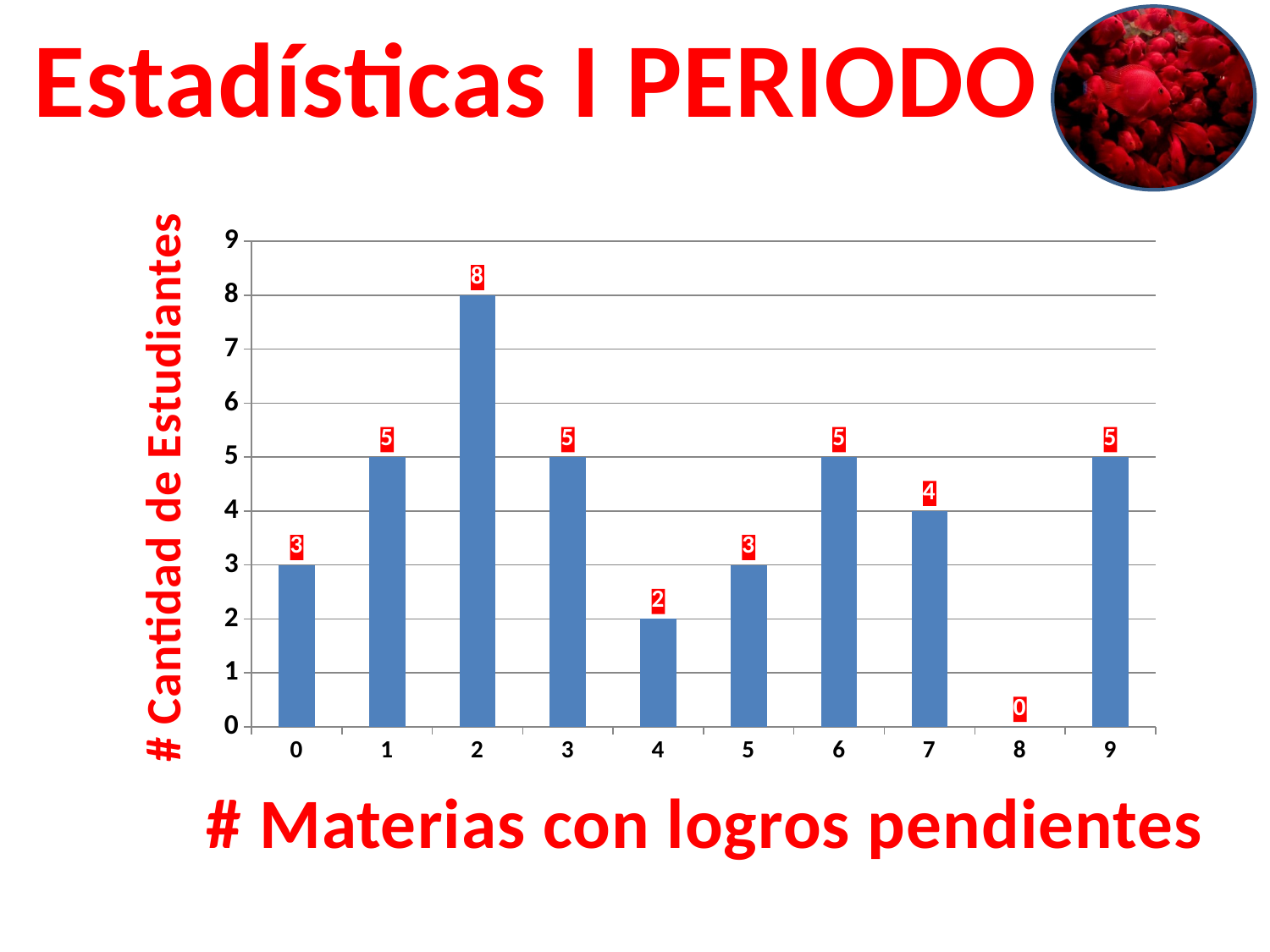
What is the number of students for category 8 on the x axis? 0 Which category on the x axis has the lowest number of students? 8 Which has more students, category 0 or category 7? 7 How many categories are shown on the x axis? 10 What is the label of the vertical axis? # Cantidad de Estudiantes How many students have 2 subjects with pending achievements (materias con logros pendientes)? 8 What is the total number of students across categories 0, 1 and 2? 16 What is the label of the horizontal axis? # Materias con logros pendientes What is the number of students for category 7 on the x axis? 4 Which category on the x axis has the highest number of students? 2 What is the difference between the number of students for category 2 and category 4? 6 What kind of chart is shown on the slide? bar chart